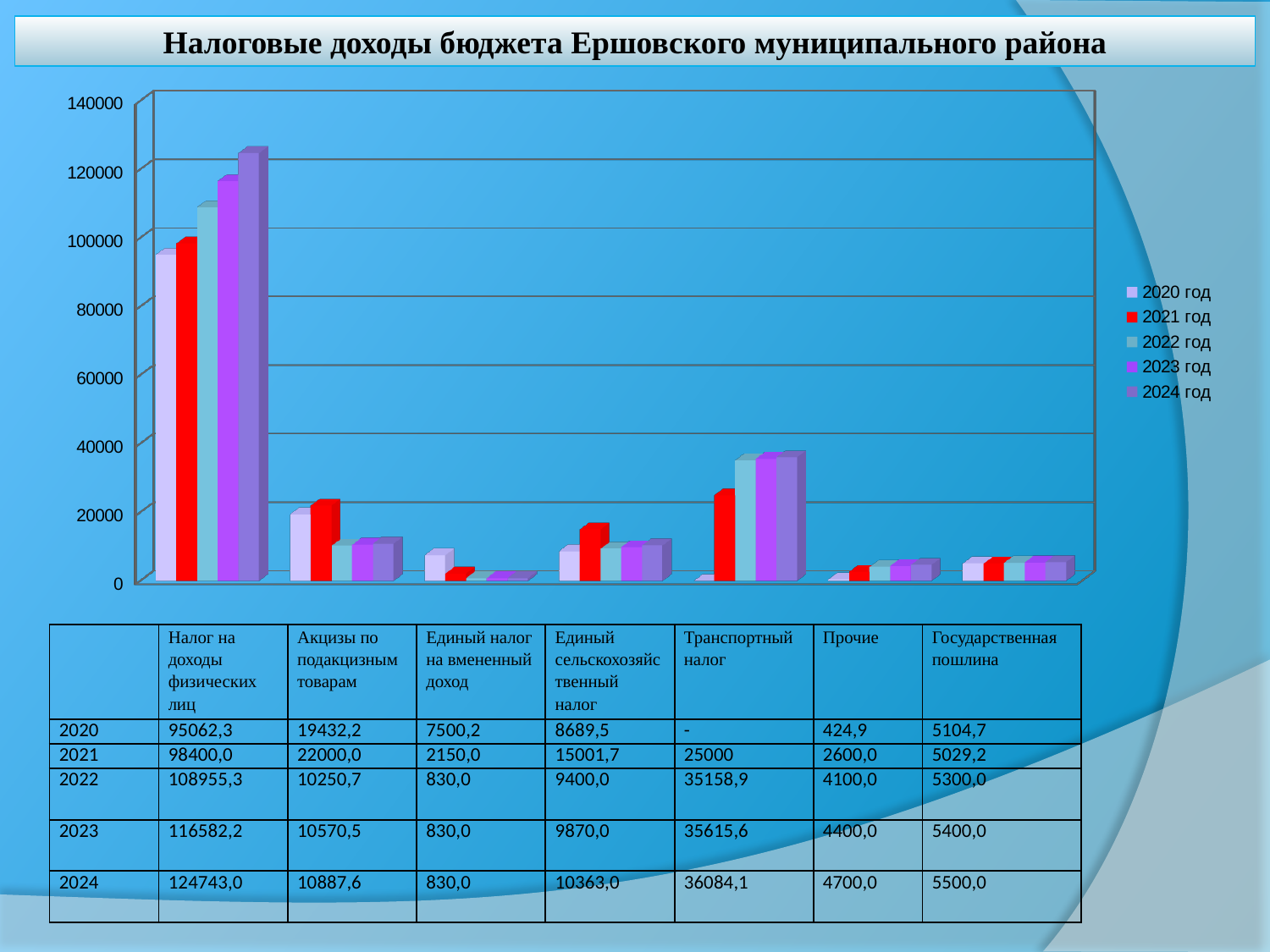
How many tax categories are plotted on the chart? 7 What is the difference between the 2021 and 2020 values for Налог на доходы физических лиц? 3337,7 Which category has the highest value in 2024? Налог на доходы физических лиц What kind of chart is shown on the slide? bar chart Do the values for Налог на доходы физических лиц rise or fall from 2020 to 2024? rise Is the 2021 value for Транспортный налог greater or less than 20000? greater Is the 2024 value for Налог на доходы физических лиц greater or less than 120000? greater What is the title of the chart? Налоговые доходы бюджета Ершовского муниципального района How many series does the chart legend list? 5 Which is larger for Акцизы по подакцизным товарам: the 2021 value or the 2022 value? 2021 What is the value of Налог на доходы физических лиц for 2024? 124743,0 What is the value of Транспортный налог for 2022? 35158,9